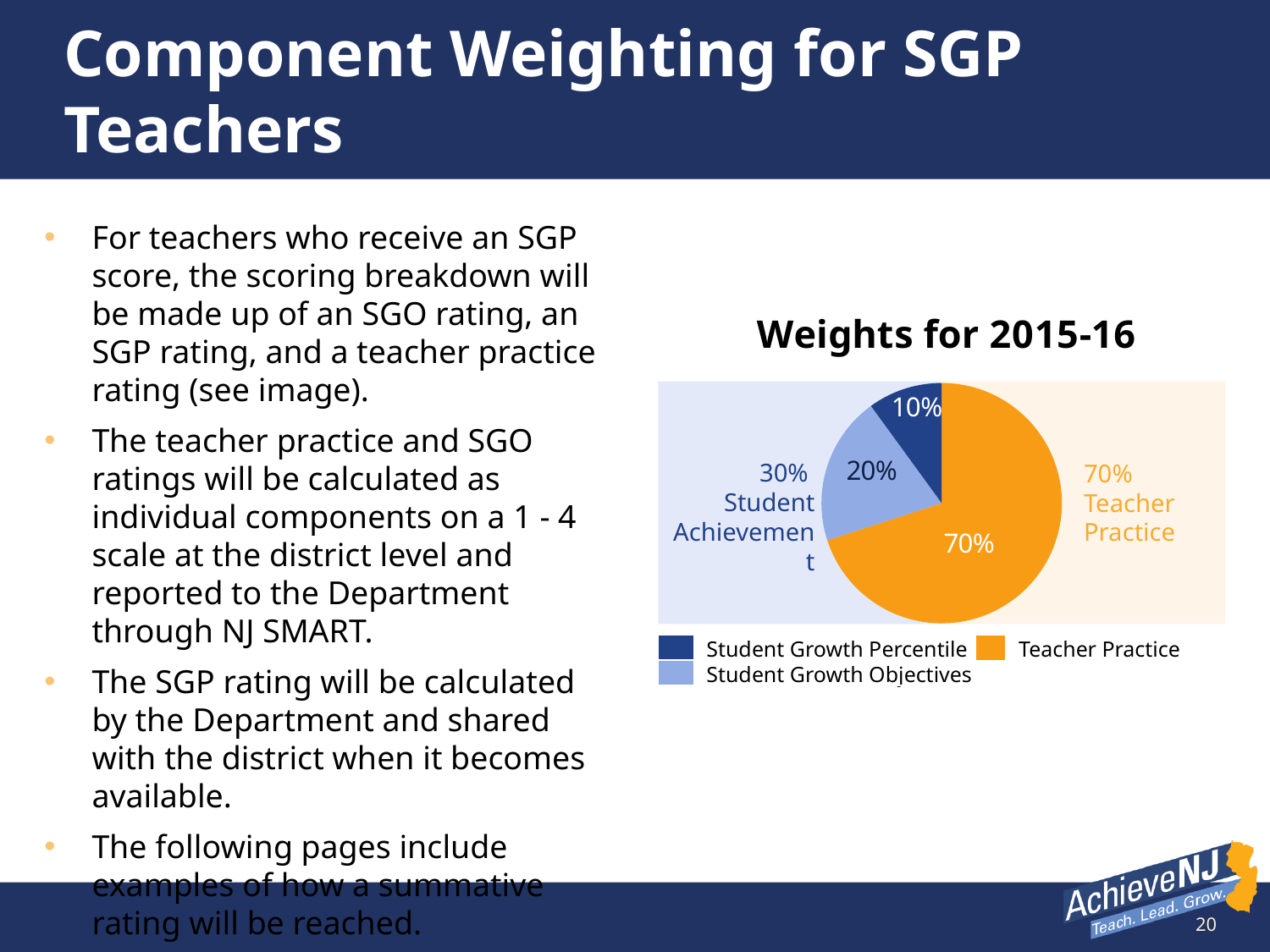
What percentage of the pie is Student Growth Objectives? 20% Which is larger, the share for Student Growth Objectives or the share for Student Growth Percentile? Student Growth Objectives What type of chart is shown under the title "Weights for 2015-16"? pie chart How many slices does the pie chart have? 3 What percentage of the pie is Student Growth Percentile? 10% What percentage of the pie is Teacher Practice? 70% What is the difference in percentage points between Teacher Practice and Student Growth Objectives? 50 How many entries does the chart legend list? 3 Which component has the smallest share of the pie? Student Growth Percentile What is the combined share of Student Growth Percentile and Student Growth Objectives? 30% What is the title of the chart on the slide? Weights for 2015-16 Which component has the largest share of the pie? Teacher Practice